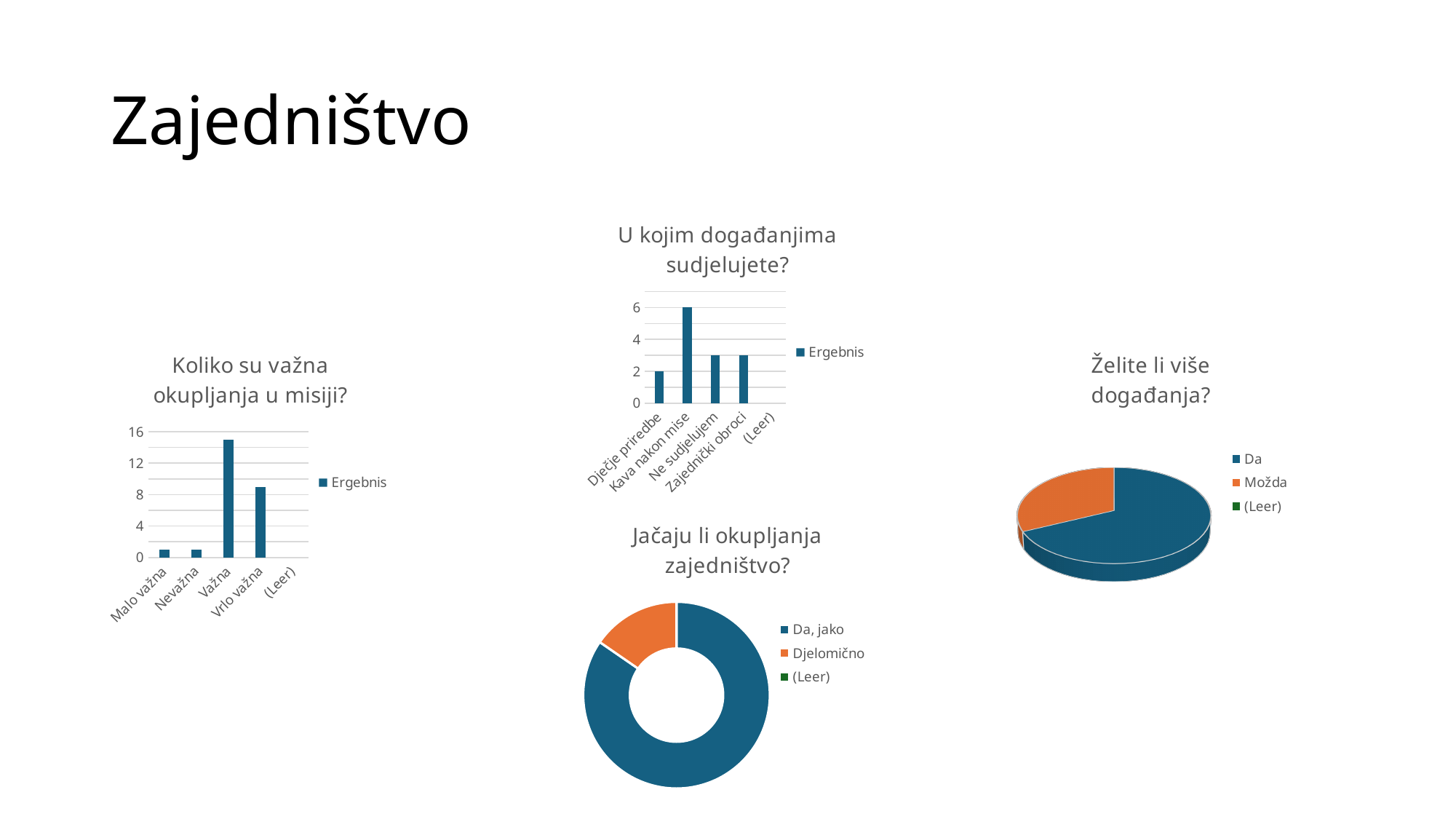
How many series does the legend of the chart "U kojim događanjima sudjelujete?" list? 1 What kind of chart is "Želite li više događanja?"? pie chart In the chart "Jačaju li okupljanja zajedništvo?", which slice is larger, Da, jako or Djelomično? Da, jako What kind of chart is "Koliko su važna okupljanja u misiji?"? bar chart In the chart "Koliko su važna okupljanja u misiji?", which is larger, the value for Važna or the value for Vrlo važna? Važna In the chart "Koliko su važna okupljanja u misiji?", is the value for Važna greater or less than 12? greater In the chart "U kojim događanjima sudjelujete?", what is the value for Kava nakon mise? 6 In the chart "Koliko su važna okupljanja u misiji?", which category has the highest value? Važna In the chart "U kojim događanjima sudjelujete?", which category has the highest value? Kava nakon mise How many categories are shown on the x axis of the chart "Koliko su važna okupljanja u misiji?"? 5 In the chart "U kojim događanjima sudjelujete?", what is the value for Dječje priredbe? 2 In the chart "U kojim događanjima sudjelujete?", is the value for Ne sudjelujem greater or less than 4? less